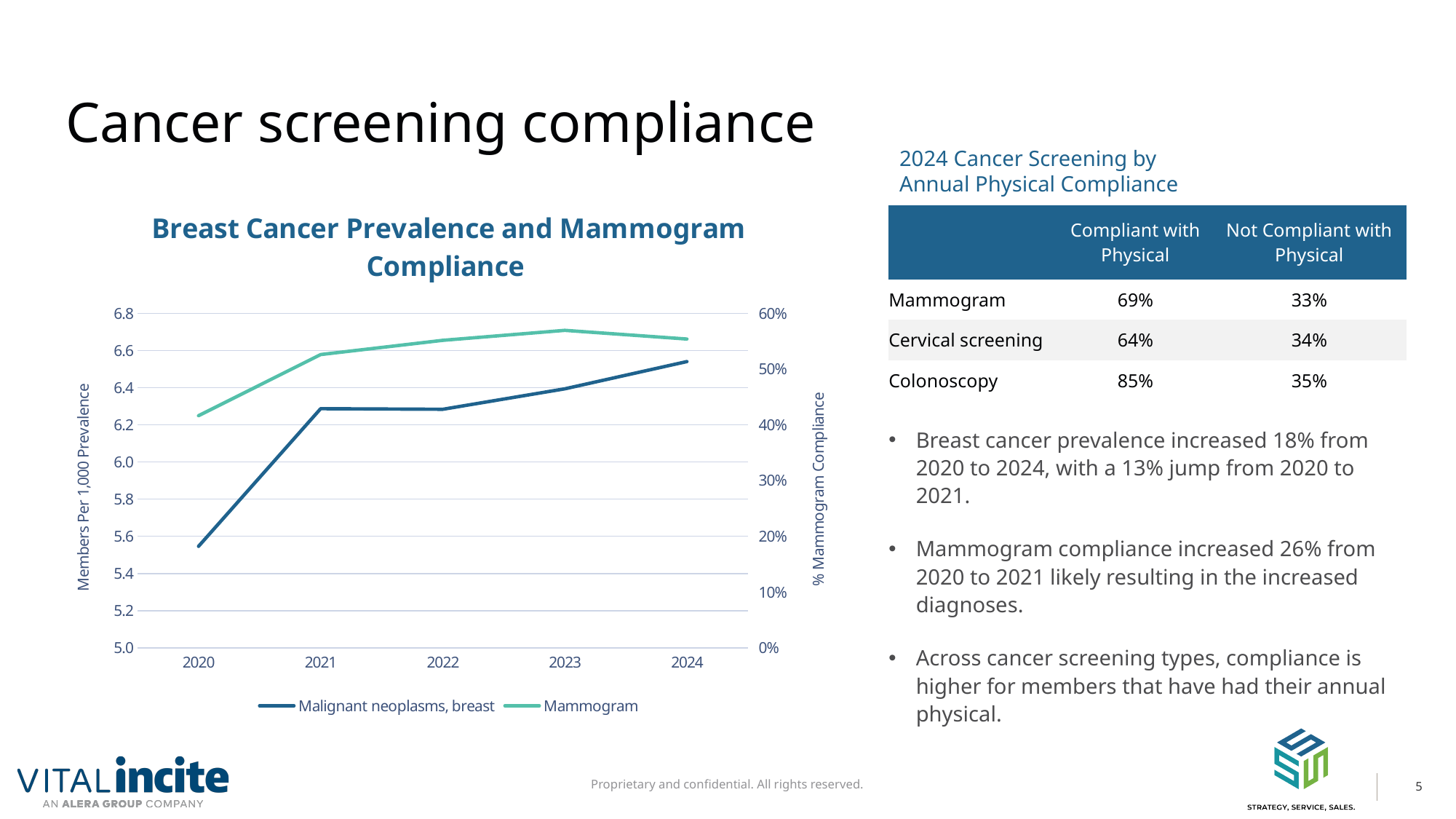
Which year has the highest Malignant neoplasms, breast value? 2024 What is the title of the chart? Breast Cancer Prevalence and Mammogram Compliance Does the Malignant neoplasms, breast line rise or fall from 2020 to 2024? Rise What kind of chart is shown on the slide? Line chart Is the Malignant neoplasms, breast value for 2024 greater or less than 6.4? greater Is the Malignant neoplasms, breast value for 2020 greater or less than 5.8? less Which year has the lowest Mammogram compliance value? 2020 Is the Mammogram compliance value for 2023 greater or less than 50%? greater How many series does the legend of the chart list? 2 How many years are plotted along the x axis of the chart? 5 Which year has the larger Mammogram compliance value, 2020 or 2021? 2021